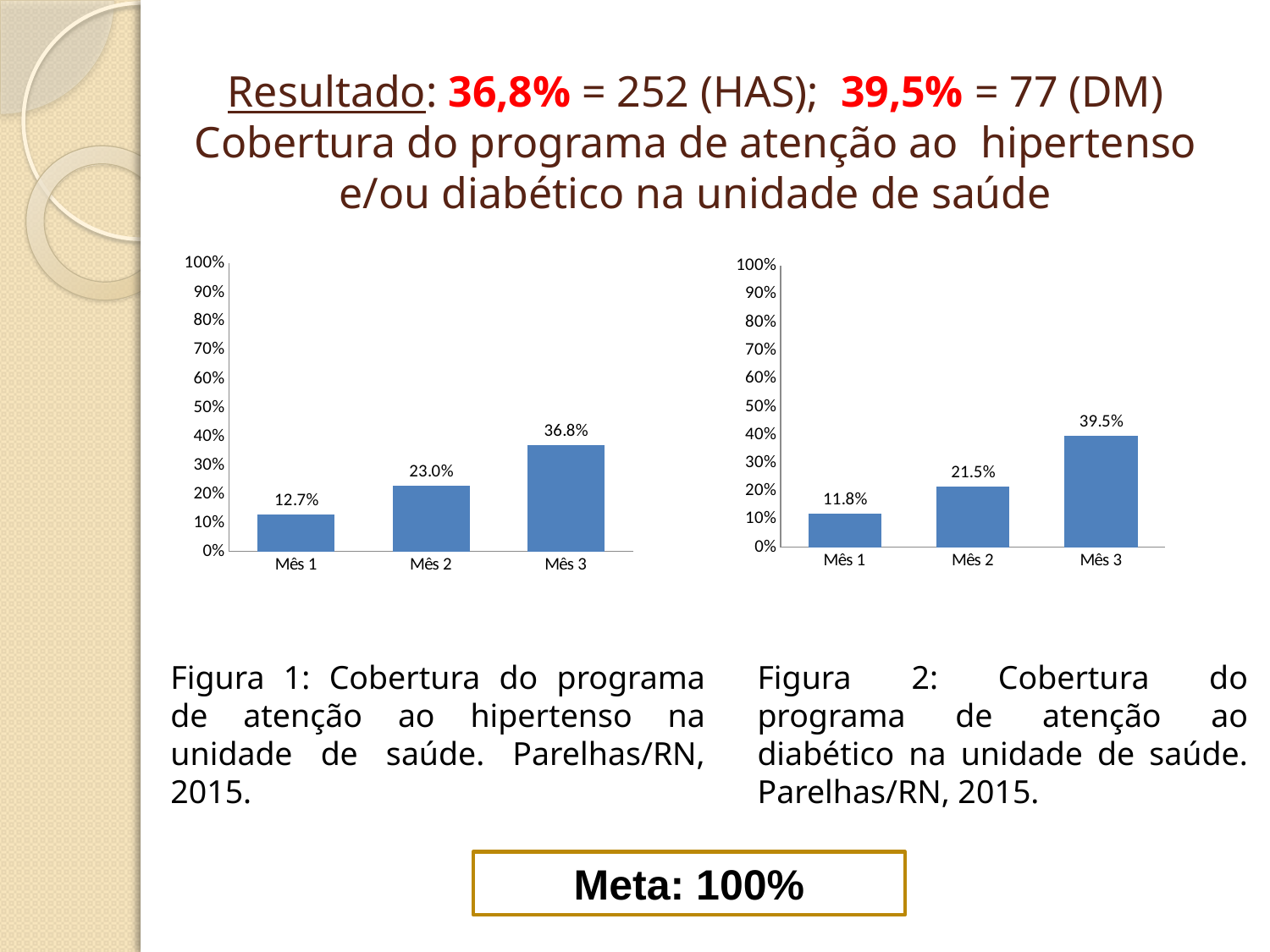
In the left chart (Figura 1, hipertenso), what is the value for Mês 3? 36.8% In the left chart (Figura 1, hipertenso), what is the difference between Mês 2 and Mês 1? 10.3% In the left chart (Figura 1, hipertenso), which month has the lowest value? Mês 1 Which is larger: Mês 3 in the left chart (Figura 1) or Mês 3 in the right chart (Figura 2)? Mês 3 in the right chart (Figura 2) In the right chart (Figura 2, diabético), is the value for Mês 2 greater or less than 30%? less In the right chart (Figura 2, diabético), what is the difference between Mês 3 and Mês 2? 18.0% How many months are shown on the x axis of the left chart (Figura 1)? 3 In the right chart (Figura 2, diabético), what is the value for Mês 1? 11.8% In the right chart (Figura 2, diabético), which month has the highest value? Mês 3 What kind of chart is the right chart (Figura 2)? bar chart In the left chart (Figura 1, hipertenso), what is the value for Mês 2? 23.0% In the left chart (Figura 1, hipertenso), do the values rise or fall from Mês 1 to Mês 3? rise